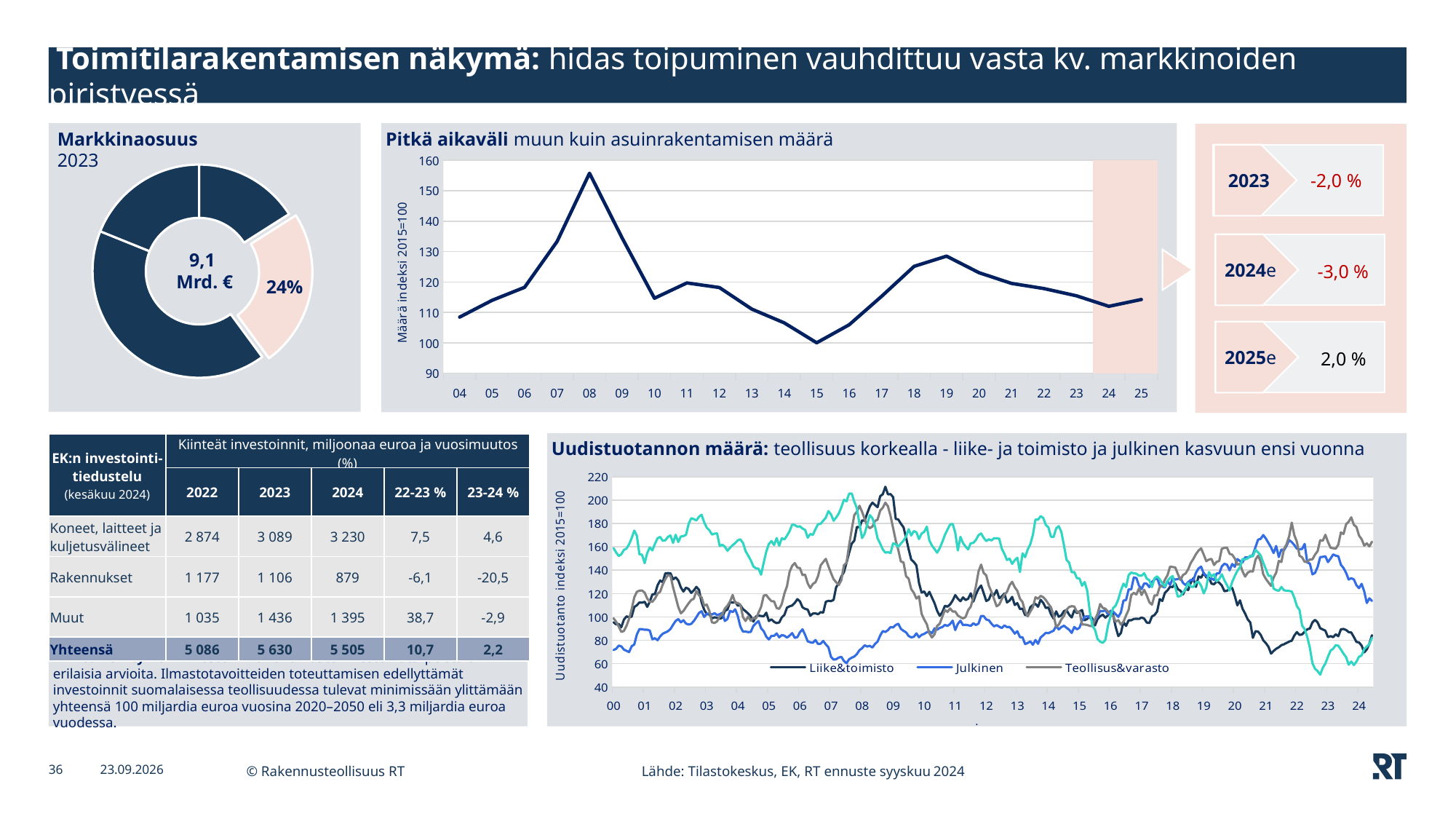
In the 'Pitkä aikaväli' line chart, is the value for 08 greater or less than 150? greater In the 'Pitkä aikaväli' line chart, which year has the lowest value? 15 In the 'Pitkä aikaväli' line chart, is the value for 15 greater or less than 110? less In the 'Markkinaosuus 2023' doughnut chart, what share is shown on the highlighted (pink) slice? 24% In the 'Uudistuotannon määrä' chart, which series has the highest value at the end of the series (24)? Teollisus&varasto What total value is printed in the centre of the 'Markkinaosuus 2023' doughnut chart? 9,1 Mrd. € What kind of chart is the 'Markkinaosuus 2023' chart on the left of the slide? Doughnut (pie) chart In the 'Pitkä aikaväli' line chart, does the line rise or fall between 15 and 19? Rises How many series does the legend of the 'Uudistuotannon määrä' chart list? 3 In the 'Pitkä aikaväli' line chart, which year has the highest value? 08 In the 'Uudistuotannon määrä' chart, is the peak value of Liike&toimisto around 09 greater or less than 200? greater What kind of chart is 'Pitkä aikaväli muun kuin asuinrakentamisen määrä'? Line chart